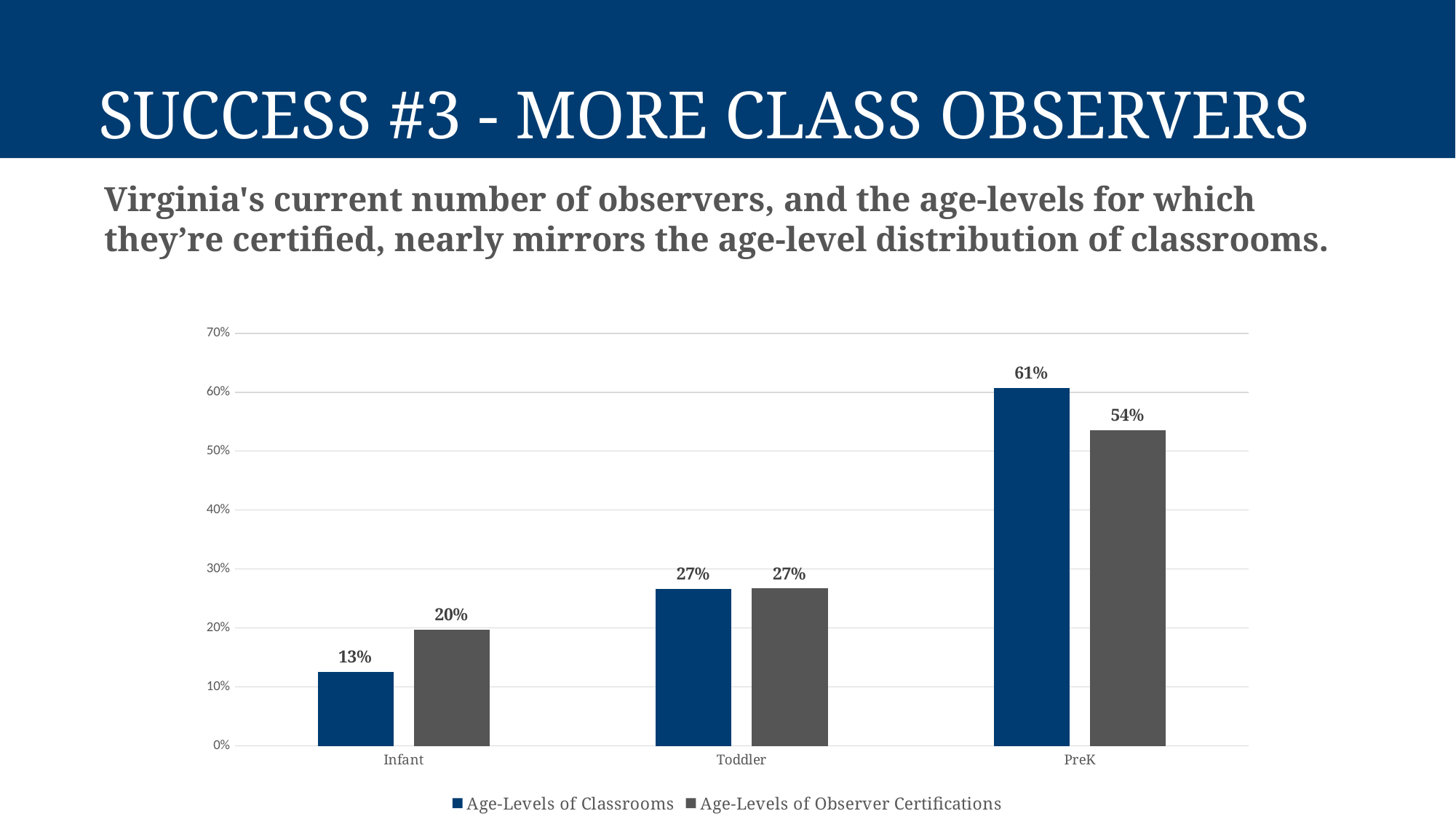
How many series does the legend list? 2 What is the value for Infant in the Age-Levels of Classrooms series? 13% Do the values in the Age-Levels of Classrooms series rise or fall from Infant to PreK? Rise What is the value for Toddler in the Age-Levels of Observer Certifications series? 27% What is the difference between the Age-Levels of Classrooms and Age-Levels of Observer Certifications values for PreK? 7% How many categories are shown on the x axis? 3 Which category has the lowest value in the Age-Levels of Observer Certifications series? Infant For Infant, which series has the larger value: Age-Levels of Classrooms or Age-Levels of Observer Certifications? Age-Levels of Observer Certifications Which category has the highest value in the Age-Levels of Classrooms series? PreK What is the value for PreK in the Age-Levels of Observer Certifications series? 54% What kind of chart is shown on the slide? Bar chart Is the value for PreK in the Age-Levels of Classrooms series greater or less than 50%? greater